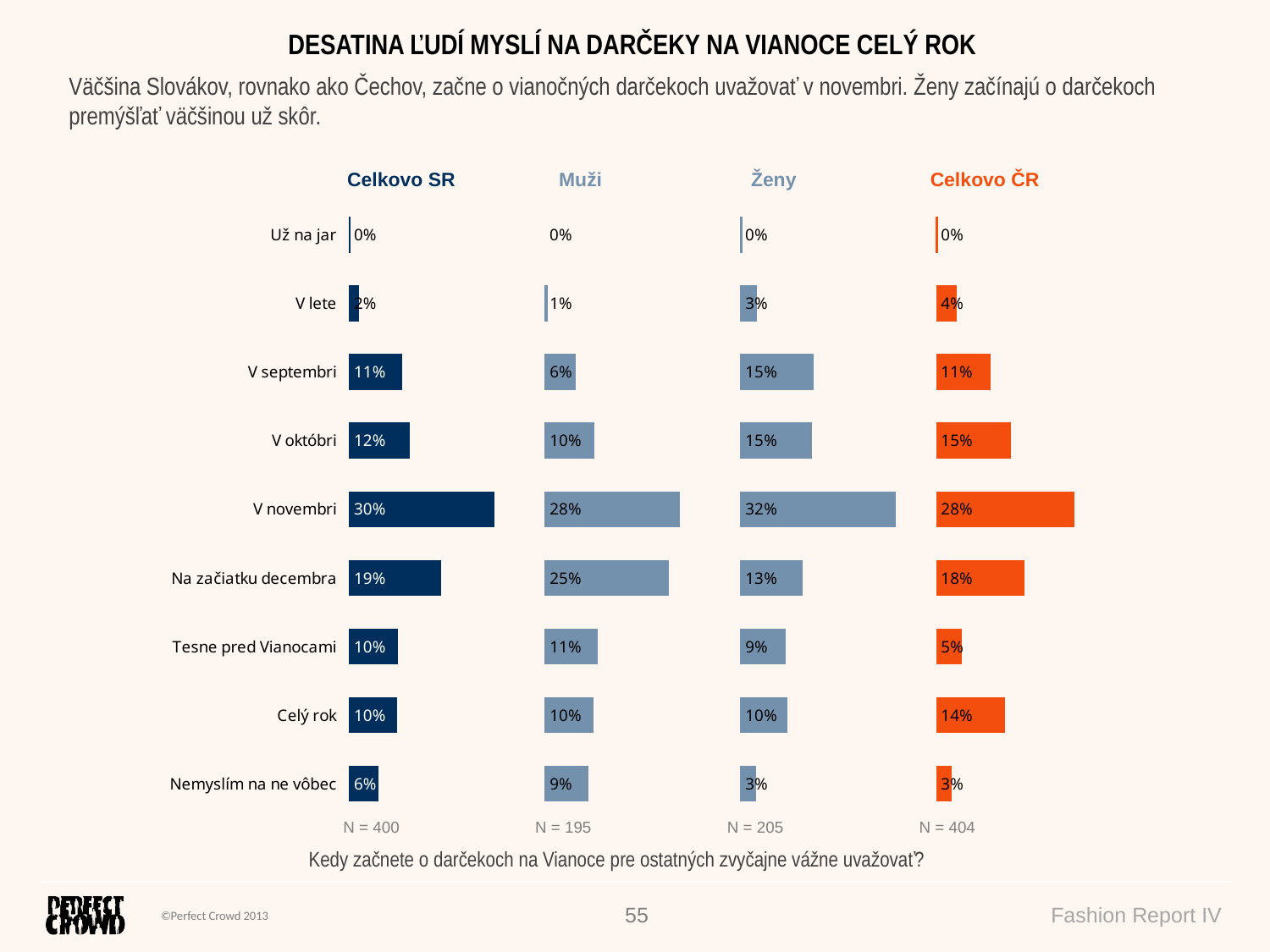
In the Celkovo ČR chart, what is the value for Celý rok? 14% What is the sample size (N) shown under the Ženy chart? N = 205 In the Celkovo SR chart, what is the difference between V novembri and Na začiatku decembra? 11% In the Celkovo SR chart, what is the value for V novembri? 30% What kind of chart is used for the Celkovo ČR data? Bar chart In the Muži chart, what is the value for Na začiatku decembra? 25% In the Celkovo ČR chart, which category has the lowest value? Už na jar In the Ženy chart, what is the value for V septembri? 15% How many categories are shown in the Celkovo SR chart? 9 In the Muži chart, which is larger: Tesne pred Vianocami or Nemyslím na ne vôbec? Tesne pred Vianocami Is the value for V novembri in the Ženy chart greater or less than the value for V novembri in the Muži chart? greater In the Ženy chart, which category has the highest value? V novembri